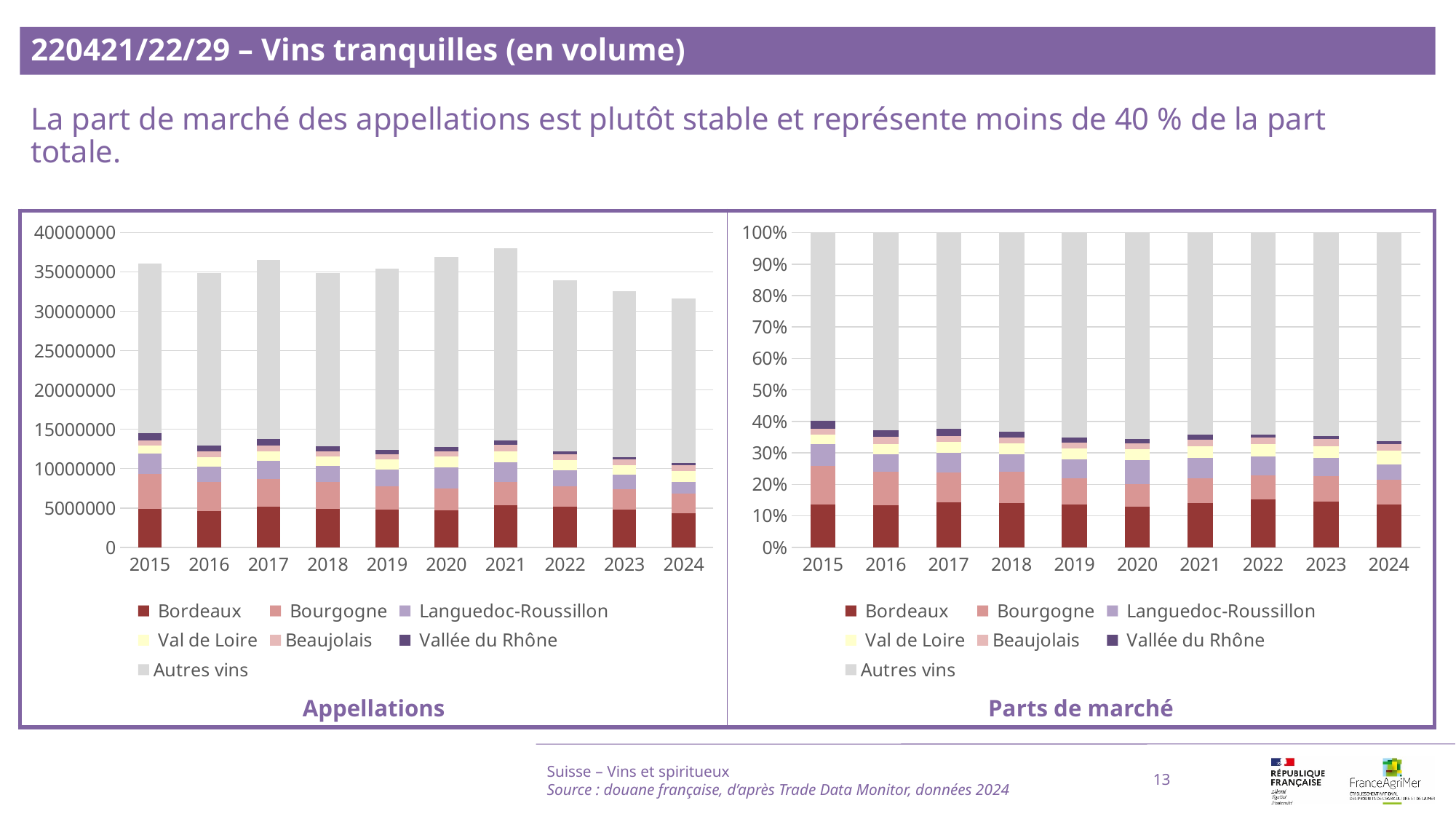
In the 'Parts de marché' chart, is the Bordeaux share in 2015 greater or less than 20%? less In the 'Appellations' chart, do the total bars rise or fall from 2021 to 2024? fall How many years are shown on the x axis of the 'Parts de marché' chart? 10 In the 'Appellations' chart, is the total bar for 2021 greater or less than 35000000? greater In the 'Parts de marché' chart, is the 'Autres vins' share in 2024 greater or less than 60%? greater In the 'Appellations' chart, which year has the highest total bar? 2021 What kind of chart is the 'Appellations' chart on the left? Stacked bar chart Which series is shown in grey in both charts? Autres vins How many series does the legend of the 'Appellations' chart list? 7 In the 'Appellations' chart, which year has the lowest total bar? 2024 In the 'Appellations' chart, is the total bar larger in 2021 or in 2024? 2021